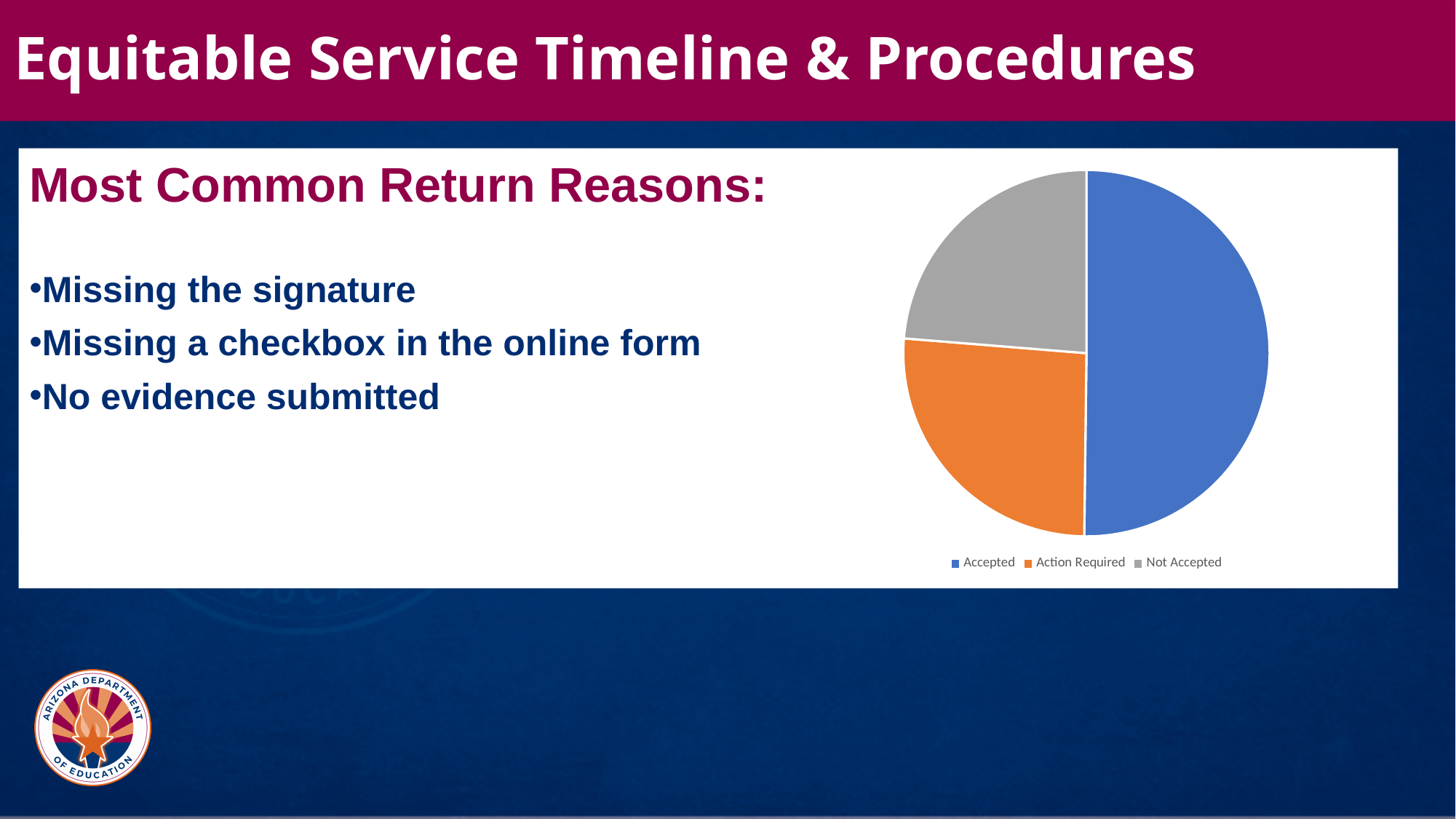
How many entries does the pie chart's legend list? 3 Which slice is larger in the pie chart, Accepted or Not Accepted? Accepted Which slice is larger in the pie chart, Accepted or Action Required? Accepted What kind of chart is shown on the slide? pie chart Which category has the largest slice in the pie chart? Accepted Which category is shown in orange in the pie chart? Action Required Which colour represents Accepted in the pie chart? blue How many slices does the pie chart have? 3